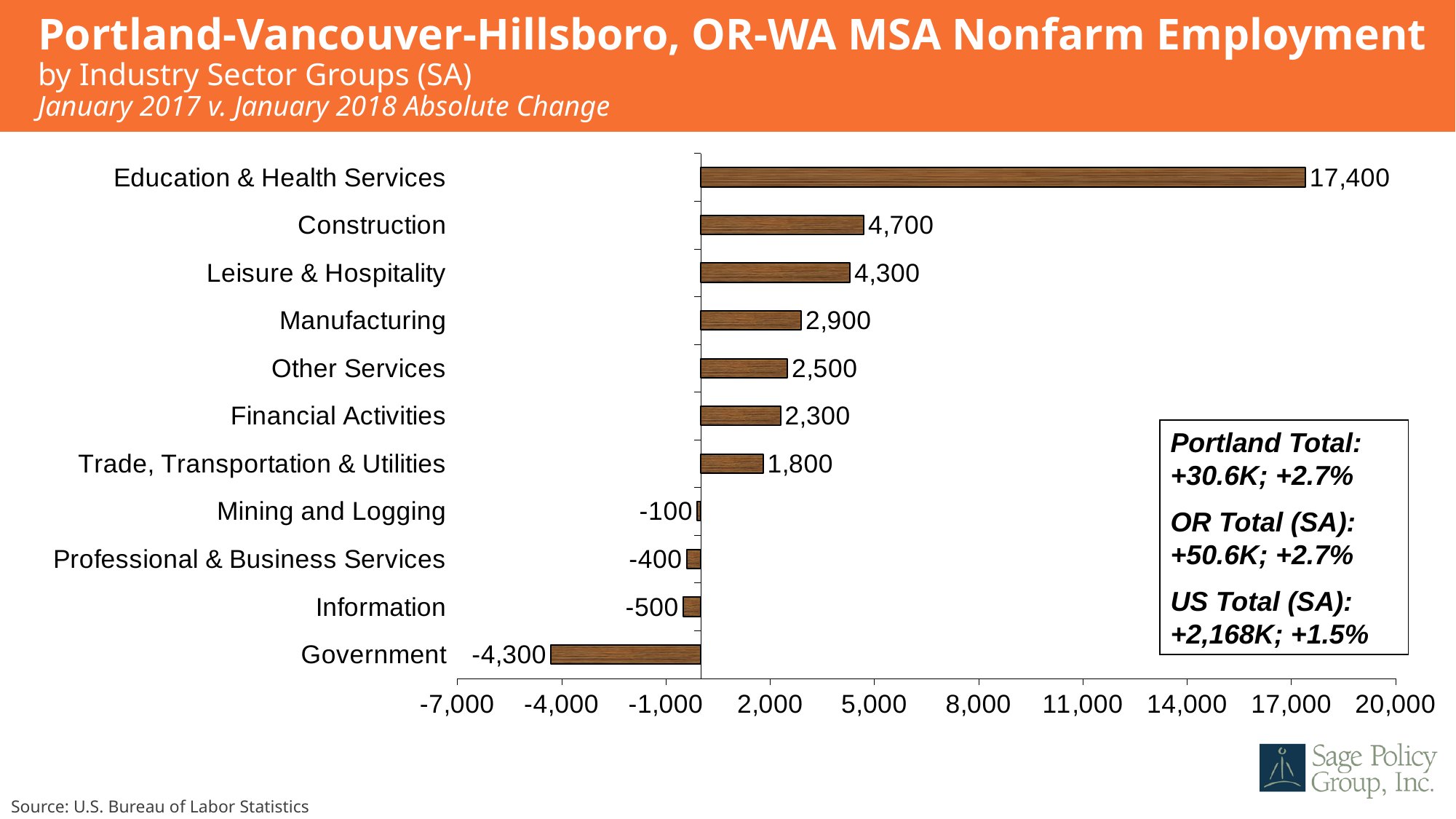
Which industry sector has the highest value? Education & Health Services What is the value for Education & Health Services? 17,400 What is the value for Government? -4,300 According to the text box on the slide, what is the Portland Total change? +30.6K; +2.7% What is the difference between the values for Education & Health Services and Construction? 12,700 What is the value for Financial Activities? 2,300 What kind of chart is shown on the slide? Bar chart Which industry sector has the lowest value? Government What is the value for Information? -500 What is the difference between the values for Construction and Leisure & Hospitality? 400 How many industry sectors are shown in the chart? 11 Which is larger, the value for Manufacturing or the value for Other Services? Manufacturing